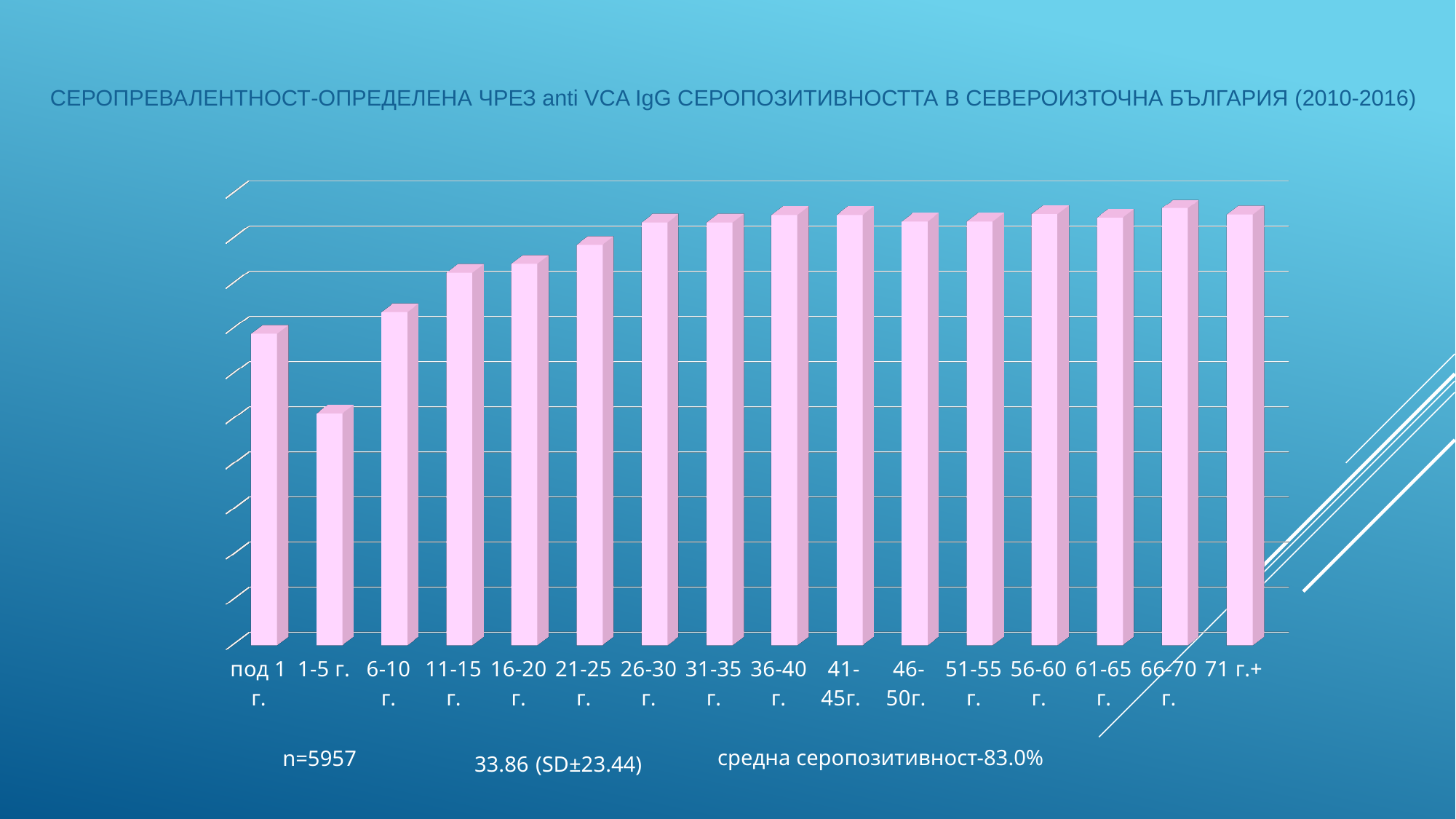
Which bar is taller, "под 1 г." or "6-10 г."? 6-10 г. Do the bar heights rise or fall from "1-5 г." to "26-30 г."? rise Which bar is taller, "6-10 г." or "11-15 г."? 11-15 г. How many age-group categories are plotted on the x axis? 16 What kind of chart is shown on the slide? bar chart What average seropositivity is stated below the chart? 83.0% Which bar is taller, "под 1 г." or "1-5 г."? под 1 г. Which age group has the lowest bar? 1-5 г. What sample size (n) is stated below the chart? n=5957